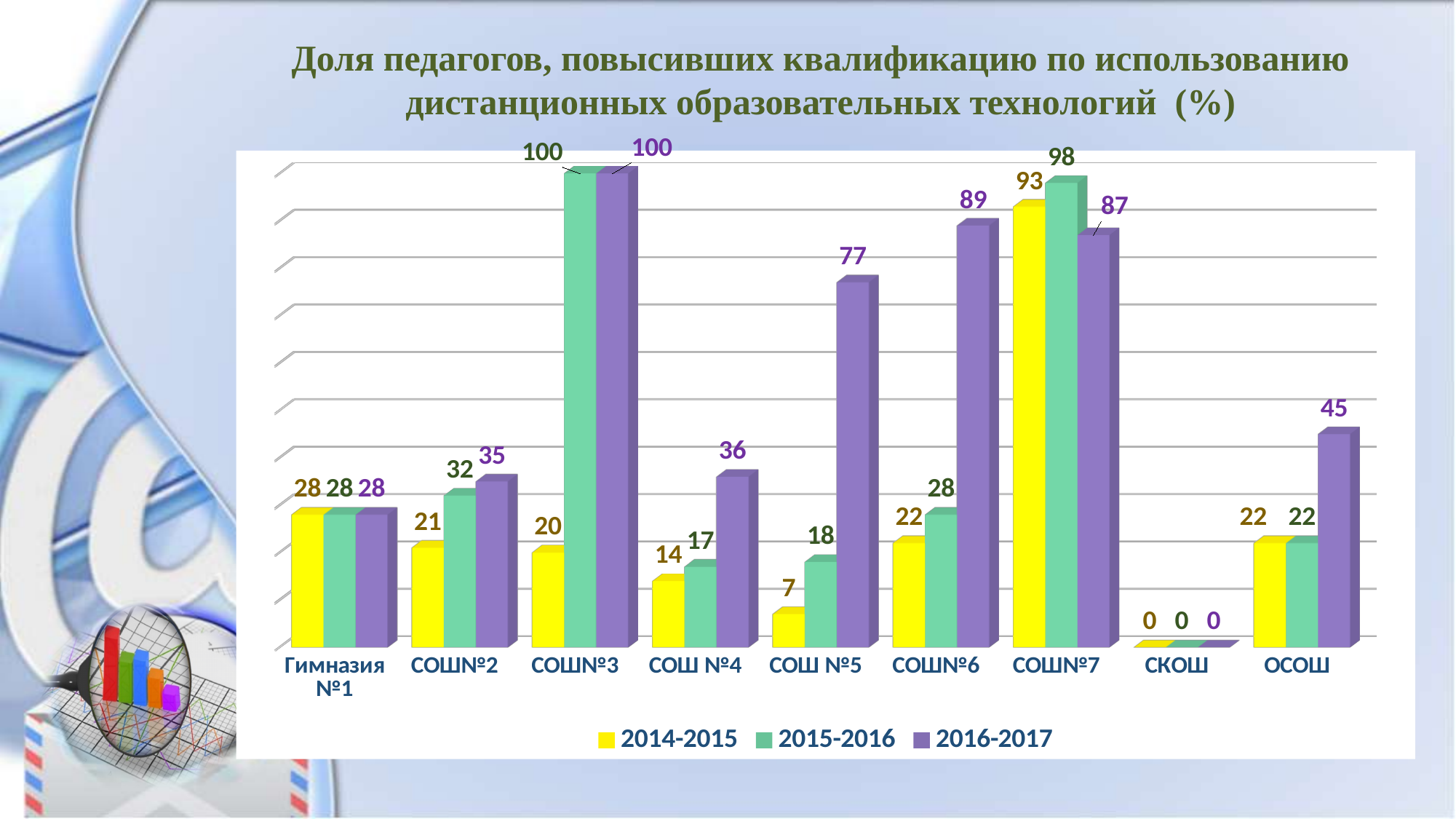
What is the difference between the 2016-2017 and 2014-2015 values for СОШ№6? 67 How many categories are shown on the x axis? 9 How many series does the legend list? 3 What kind of chart is shown on the slide? bar chart Which is larger for СОШ№7: the 2015-2016 value or the 2016-2017 value? 2015-2016 Do the values for СОШ №4 rise or fall from 2014-2015 to 2016-2017? rise Which colour represents the 2015-2016 series in the legend? green What is the value for СОШ№7 in the 2014-2015 series? 93 Which category has the highest value in the 2014-2015 series? СОШ№7 Which category has the lowest value in the 2016-2017 series? СКОШ What is the value for СОШ №5 in the 2016-2017 series? 77 What is the value for ОСОШ in the 2016-2017 series? 45